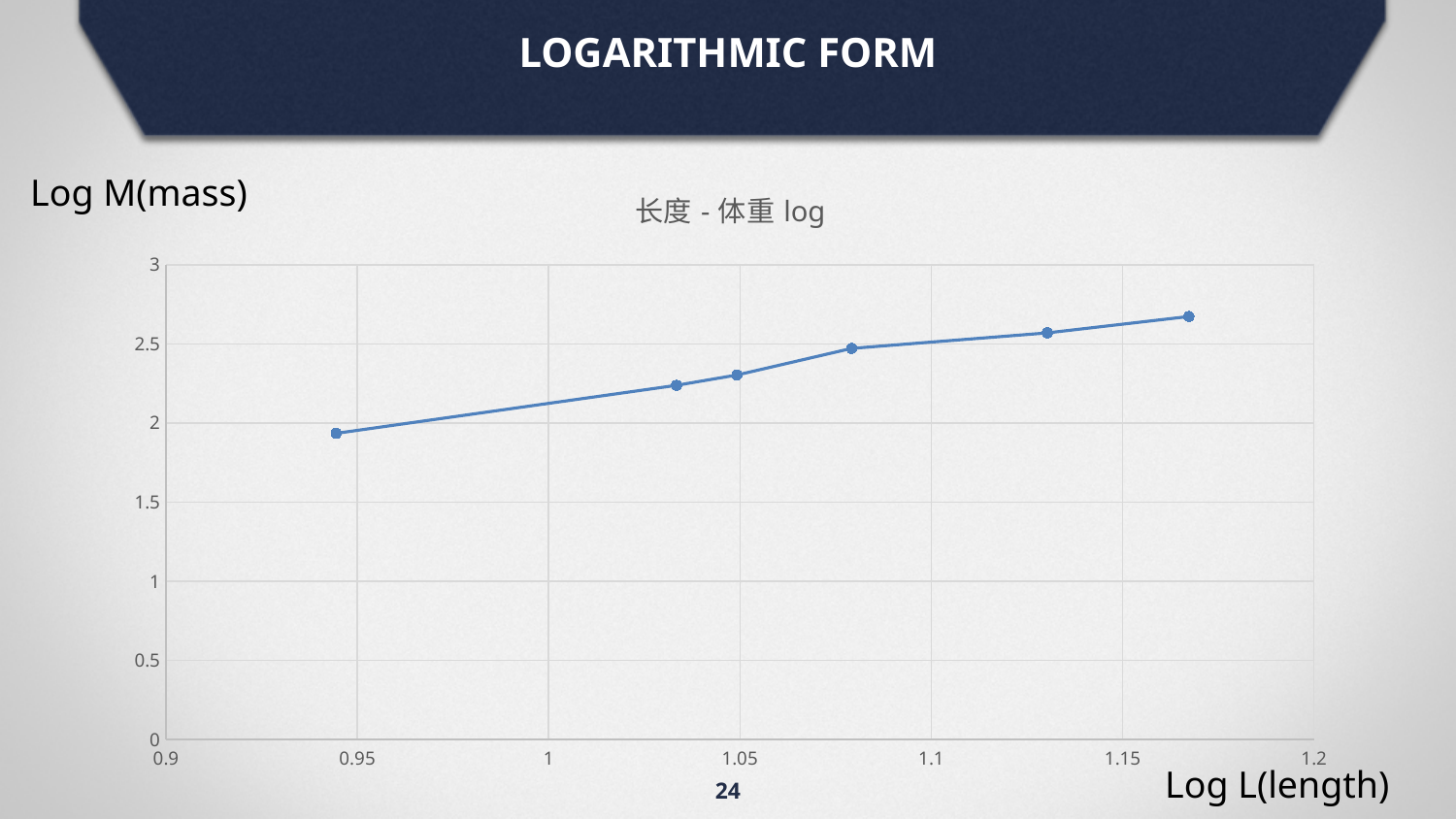
Which data point has the highest Log M(mass) value, the leftmost or the rightmost? the rightmost Is the value of the rightmost data point (near x = 1.17) greater or less than 2.5? greater Is the value of the leftmost data point (near x = 0.95) greater or less than 2? less Is the value of the data point at x = 1.05 greater or less than 2.5? less What label is given to the vertical axis of the chart? Log M(mass) What is the title of the chart? 长度 - 体重 log What kind of chart is shown on the slide? line chart What is the maximum value shown on the y axis? 3 How many data points are plotted on the chart? 6 Do the plotted values rise or fall as Log L(length) increases along the x axis? rise